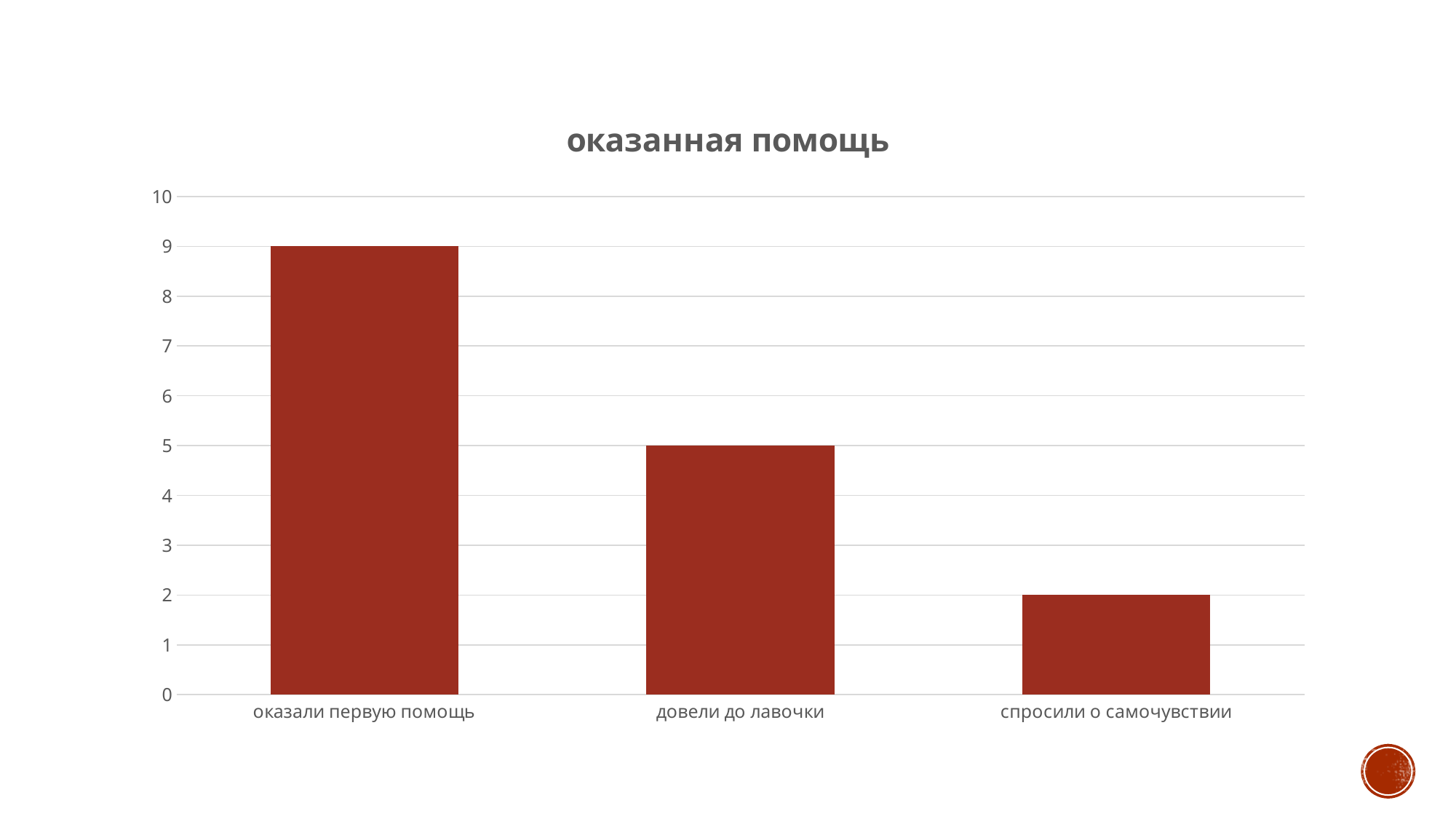
What is the title of the chart? оказанная помощь Which category has the highest value? оказали первую помощь What is the difference between the values for "довели до лавочки" and "спросили о самочувствии"? 3 What is the difference between the values for "оказали первую помощь" and "довели до лавочки"? 4 Which is larger: the value for "довели до лавочки" or the value for "спросили о самочувствии"? довели до лавочки What kind of chart is shown on the slide? bar chart What is the value for "спросили о самочувствии"? 2 What is the value for "довели до лавочки"? 5 What is the value for "оказали первую помощь"? 9 Is the value for "оказали первую помощь" greater or less than 8? greater How many categories are shown on the chart? 3 Which category has the lowest value? спросили о самочувствии